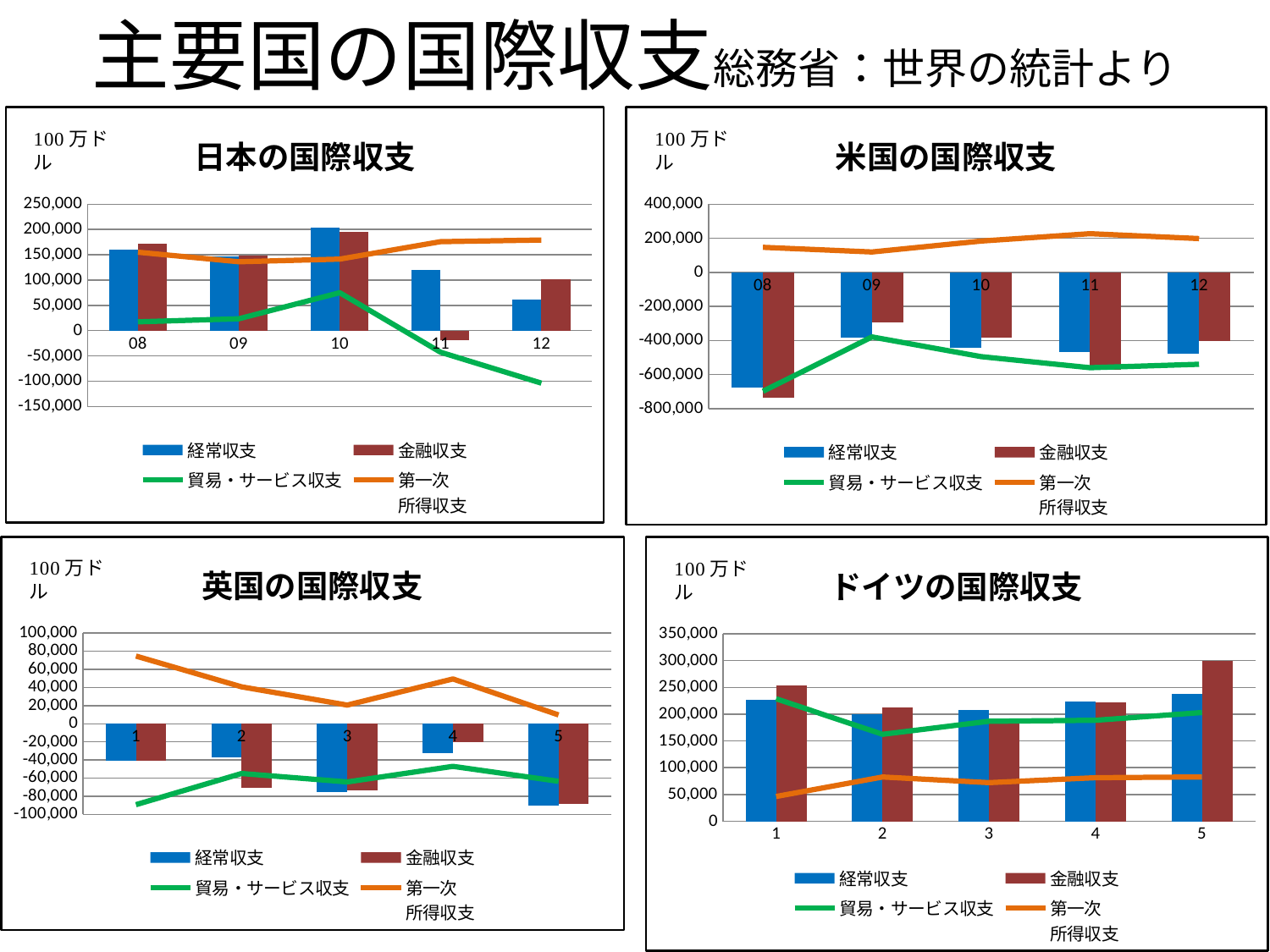
In the ドイツの国際収支 chart, does 貿易・サービス収支 rise or fall from category 2 to category 5? rise In the 日本の国際収支 chart, is the value of 貿易・サービス収支 for 12 greater or less than -50,000? less In the 日本の国際収支 chart, which year has the lowest value for 金融収支? 11 In the 英国の国際収支 chart, is the value of 貿易・サービス収支 for category 1 greater or less than -80,000? less In the 米国の国際収支 chart, which year has the highest value for 第一次所得収支? 11 How many categories are shown on the x axis of the 英国の国際収支 chart? 5 In the 日本の国際収支 chart, which year has the highest value for 経常収支? 10 In the 米国の国際収支 chart, is the value of 金融収支 for 08 greater or less than -600,000? less In the 英国の国際収支 chart, which category has the highest value for 第一次所得収支? 1 In the ドイツの国際収支 chart, which is larger at category 5: 経常収支 or 金融収支? 金融収支 In the 米国の国際収支 chart, which year has the lowest value for 経常収支? 08 How many series does the legend of the 米国の国際収支 chart list? 4